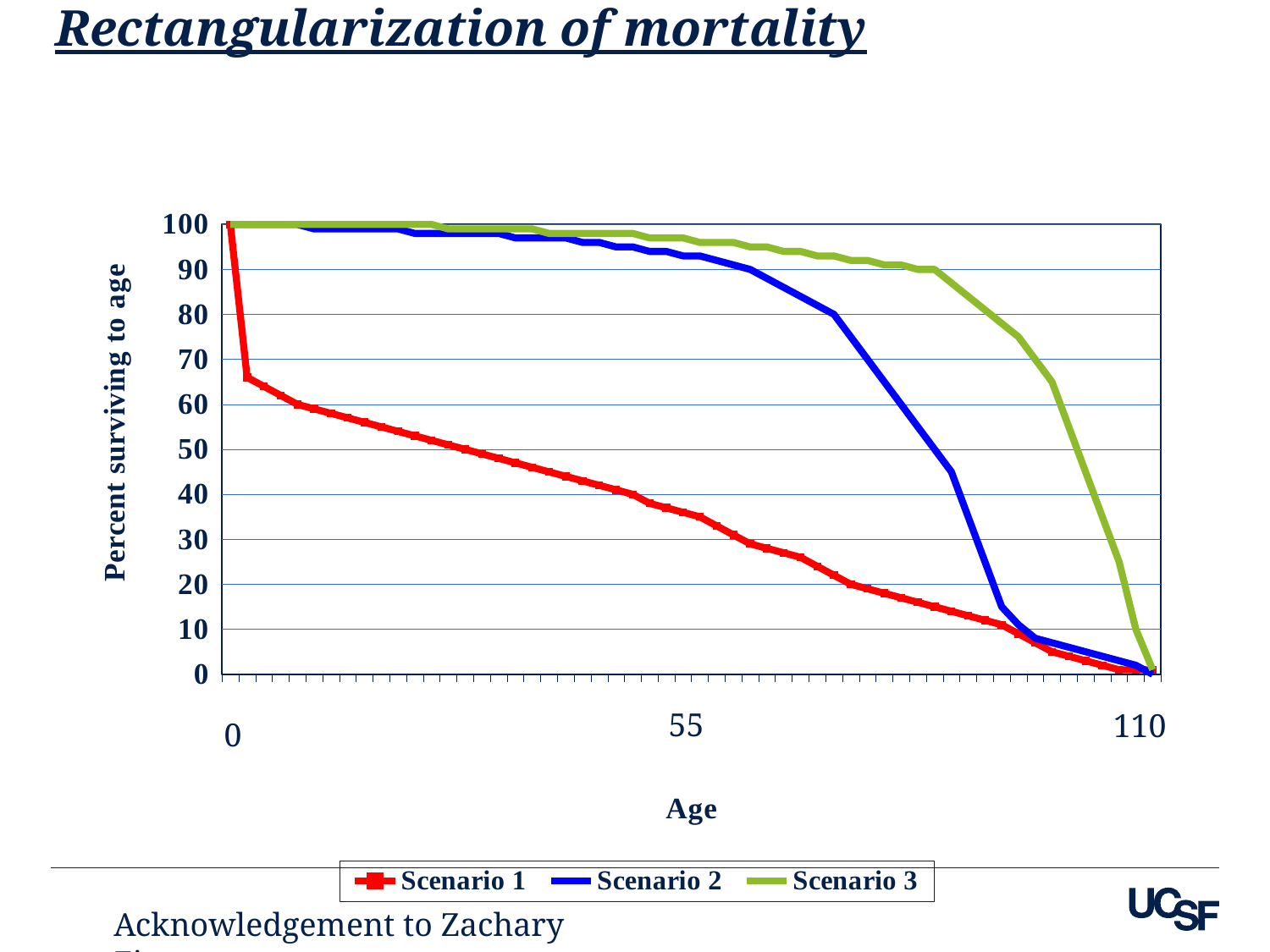
Is the value for Scenario 2 at age 55 greater or less than 80? greater Is the value for Scenario 1 at age 55 greater or less than 40? less What is the title of the chart on the slide? Rectangularization of mortality What is the label of the vertical axis? Percent surviving to age Which series is drawn in red? Scenario 1 Which scenario has the lowest percent surviving at age 55? Scenario 1 What kind of chart is shown on the slide? line chart Is the value for Scenario 3 at age 55 greater or less than 90? greater Do the values for Scenario 1 rise or fall as age increases? fall How many series does the legend list? 3 At age 55, which is larger: the value for Scenario 1 or the value for Scenario 2? Scenario 2